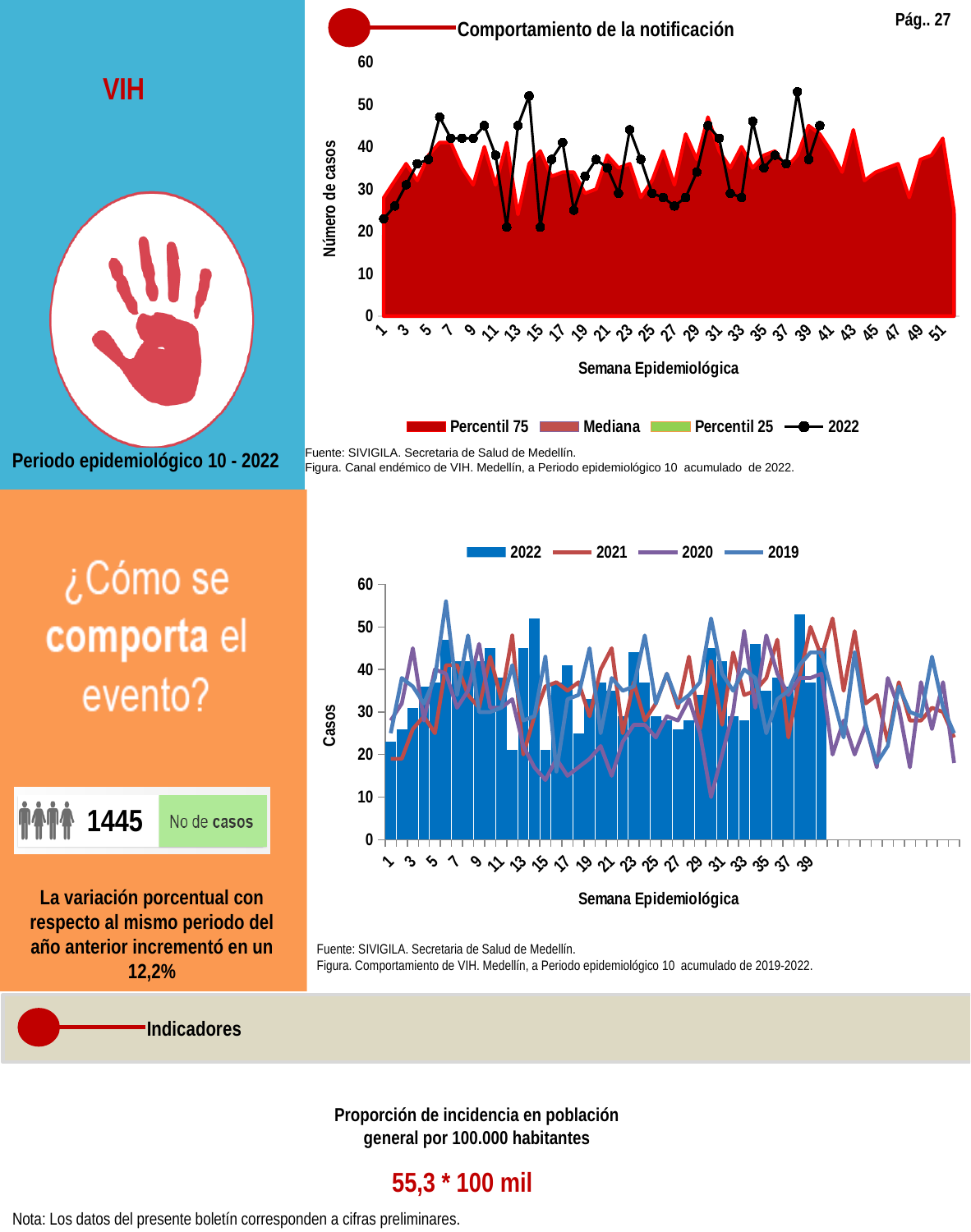
In the top chart 'Comportamiento de la notificación', which legend entry is drawn as a black line with markers? 2022 In the top chart 'Comportamiento de la notificación', what is the label of the y axis? Número de casos In the top chart 'Comportamiento de la notificación', is the 2022 value for week 12 greater or less than 30? less In the top chart 'Comportamiento de la notificación', is the 2022 value for week 1 greater or less than 30? less In the bottom chart, is the 2022 value for week 1 greater or less than 30? less In the bottom chart, which series is shown as bars? 2022 In the top chart 'Comportamiento de la notificación', how many series does the legend list? 4 In the bottom chart, how many series does the legend list? 4 In the bottom chart, what is the label of the x axis? Semana Epidemiológica